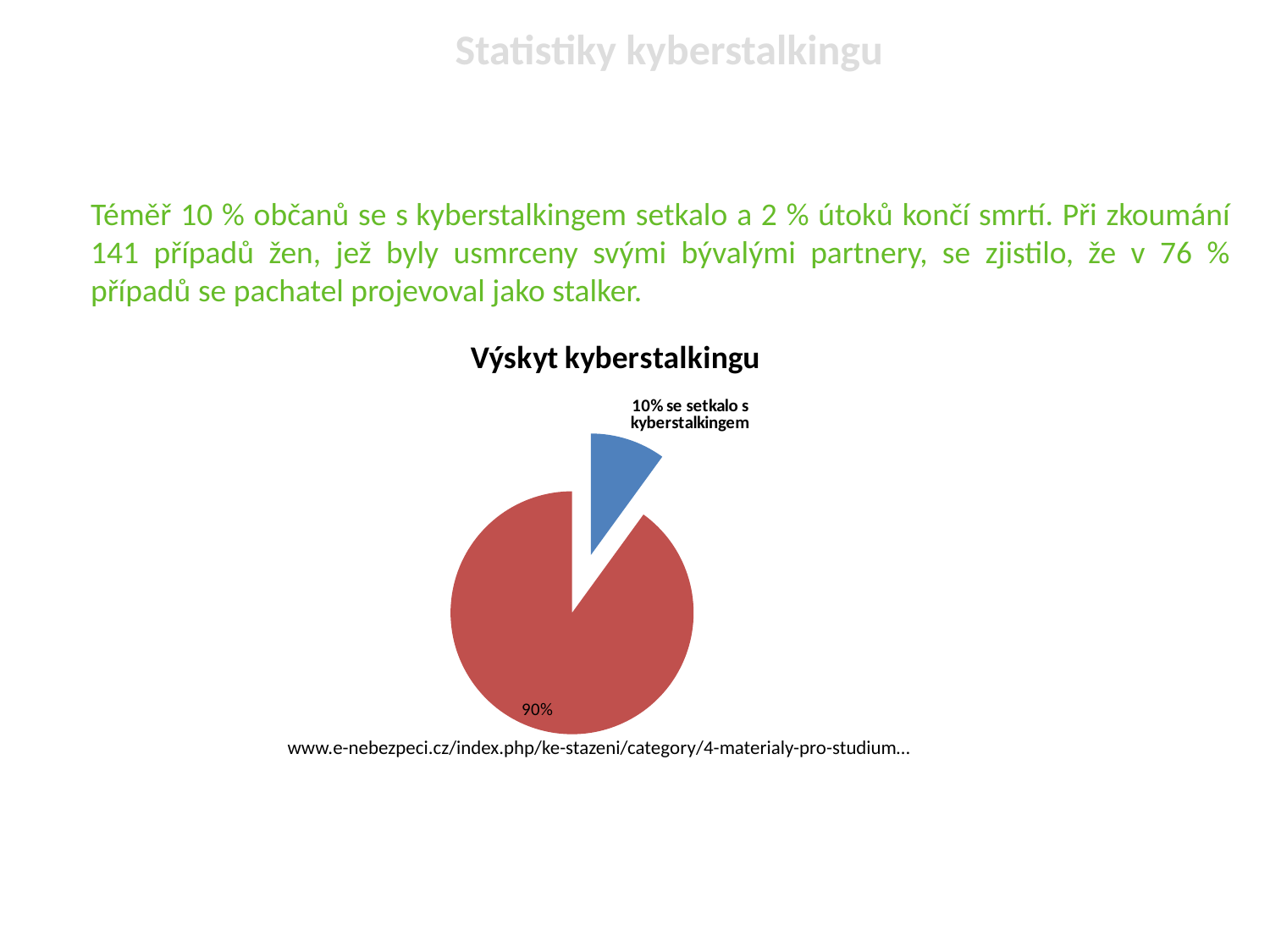
Which is larger: the slice labelled 90% or the slice labelled "10% se setkalo s kyberstalkingem"? 90% Which slice is the smallest in the pie chart? 10% se setkalo s kyberstalkingem What kind of chart is shown on the slide? pie chart Which slice is the largest in the pie chart? 90% What is the difference between the two slices of the pie chart? 80% What share of the pie does the larger (red) slice represent? 90% What share of the pie is labelled "10% se setkalo s kyberstalkingem"? 10% What colour is the slice labelled "10% se setkalo s kyberstalkingem"? blue What is the total of the two slices shown in the pie chart? 100% What is the title of the chart? Výskyt kyberstalkingu How many slices does the pie chart have? 2